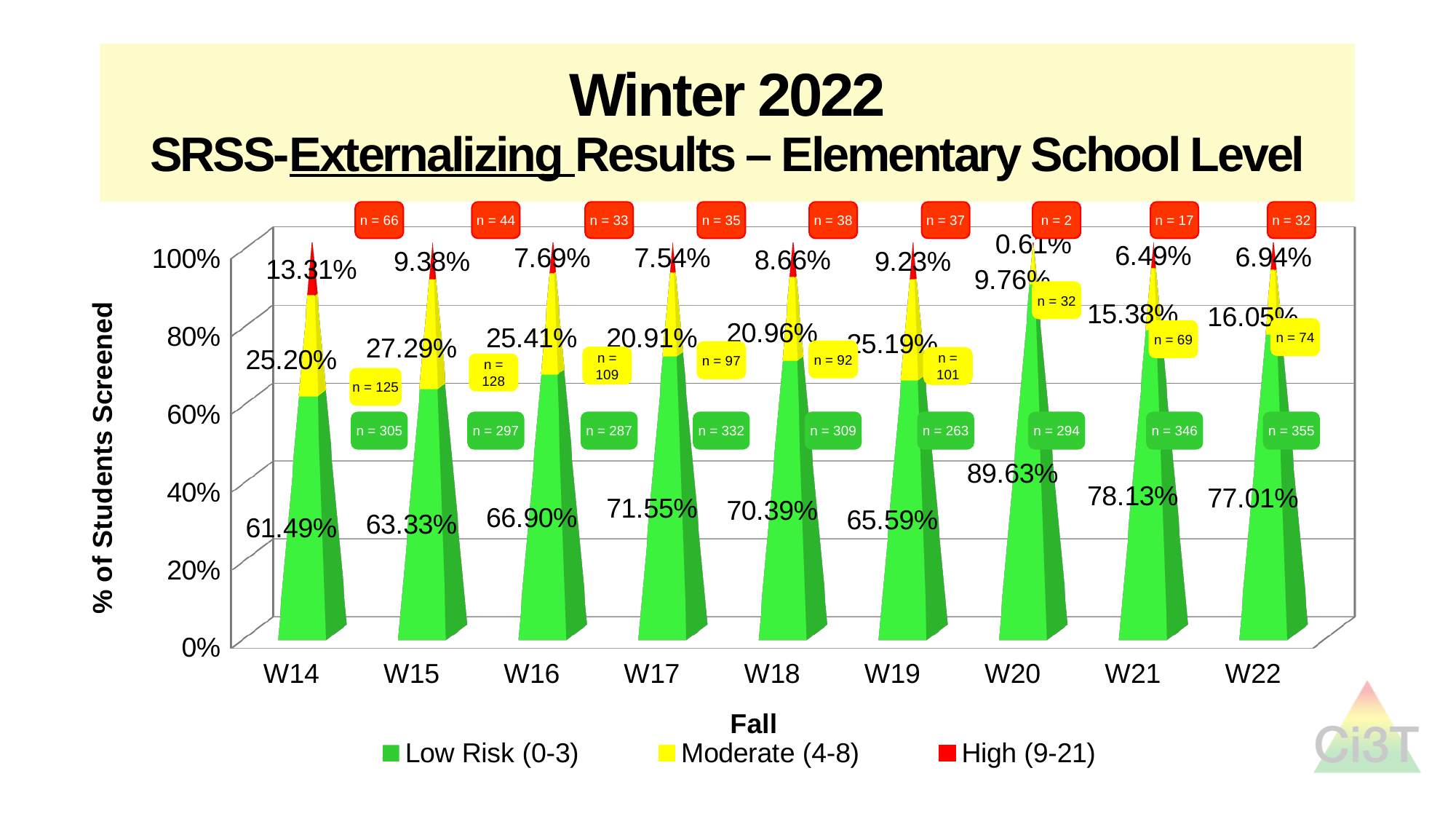
What is the Moderate (4-8) percentage for W17? 20.91% What kind of chart is shown on the slide? Stacked bar chart Which school has the lowest Low Risk (0-3) percentage? W14 Which school has the highest Low Risk (0-3) percentage? W20 What percentage of students screened at W20 were Low Risk (0-3)? 89.63% What percentage of students screened at W14 were in the High (9-21) category? 13.31% What is the label of the y axis? % of Students Screened How many series does the legend list? 3 Which has a larger Low Risk (0-3) percentage, W17 or W18? W17 Which school has the lowest High (9-21) percentage? W20 How many schools are shown on the x axis? 9 What is the difference in Low Risk (0-3) percentage between W20 and W14? 28.14 percentage points